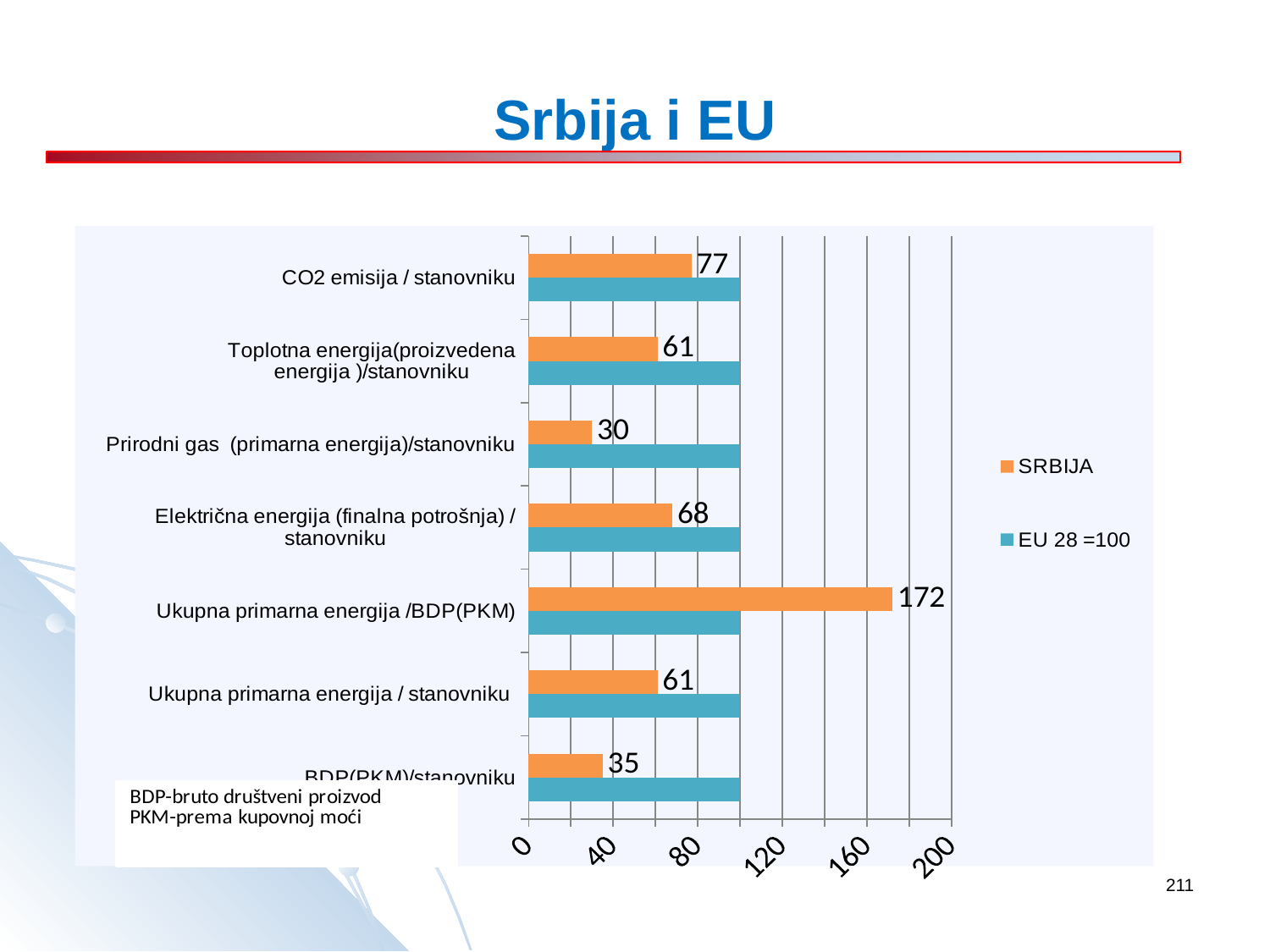
How many categories are shown on the chart? 7 Is the SRBIJA value for Ukupna primarna energija /BDP(PKM) greater or less than 160? greater What is the difference between the SRBIJA values for CO2 emisija / stanovniku and Prirodni gas (primarna energija)/stanovniku? 47 What is the SRBIJA value for Prirodni gas (primarna energija)/stanovniku? 30 What is the SRBIJA value for Električna energija (finalna potrošnja) / stanovniku? 68 What is the SRBIJA value for Ukupna primarna energija /BDP(PKM)? 172 Which category has the highest SRBIJA value? Ukupna primarna energija /BDP(PKM) Which category has the lowest SRBIJA value? Prirodni gas (primarna energija)/stanovniku What is the SRBIJA value for CO2 emisija / stanovniku? 77 Which is larger, the SRBIJA value for CO2 emisija / stanovniku or for Električna energija (finalna potrošnja) / stanovniku? CO2 emisija / stanovniku What type of chart is shown on the slide? bar chart How many series does the legend list? 2